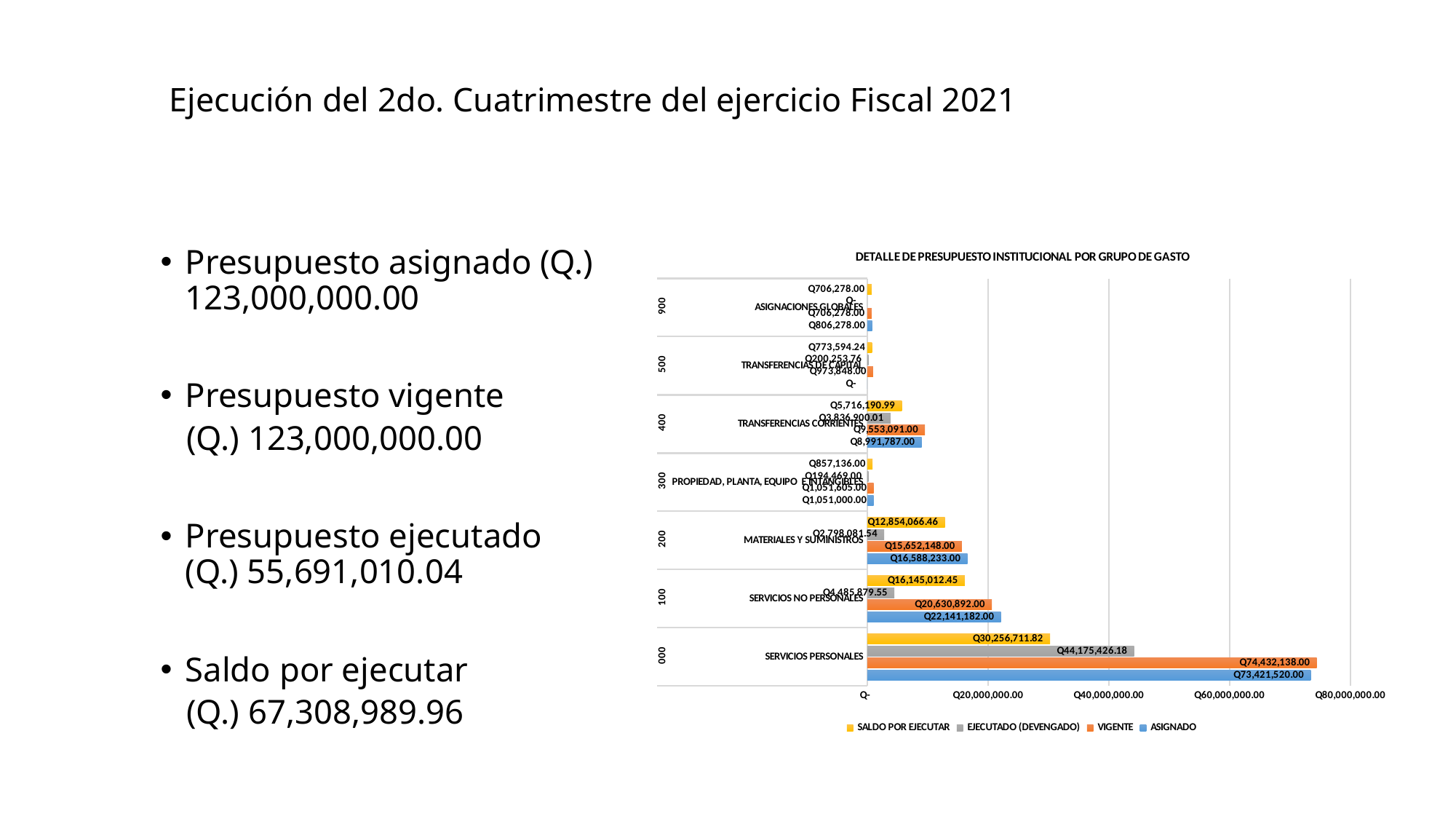
How many series does the legend of the chart list? 4 What is the ASIGNADO value for SERVICIOS NO PERSONALES? Q22,141,182.00 How many expense groups (categories) are shown on the chart? 7 What is the difference between the VIGENTE and ASIGNADO values for SERVICIOS PERSONALES? Q1,010,618.00 What is the VIGENTE value for SERVICIOS PERSONALES? Q74,432,138.00 What is the ASIGNADO value for ASIGNACIONES GLOBALES? Q806,278.00 Which expense group has the highest ASIGNADO value? SERVICIOS PERSONALES What is the SALDO POR EJECUTAR value for TRANSFERENCIAS CORRIENTES? Q5,716,190.99 What is the title of the chart? DETALLE DE PRESUPUESTO INSTITUCIONAL POR GRUPO DE GASTO Is the EJECUTADO (DEVENGADO) value for SERVICIOS PERSONALES greater or less than Q40,000,000.00? greater Which has a larger SALDO POR EJECUTAR value: SERVICIOS NO PERSONALES or MATERIALES Y SUMINISTROS? SERVICIOS NO PERSONALES What kind of chart is shown on the slide? Bar chart